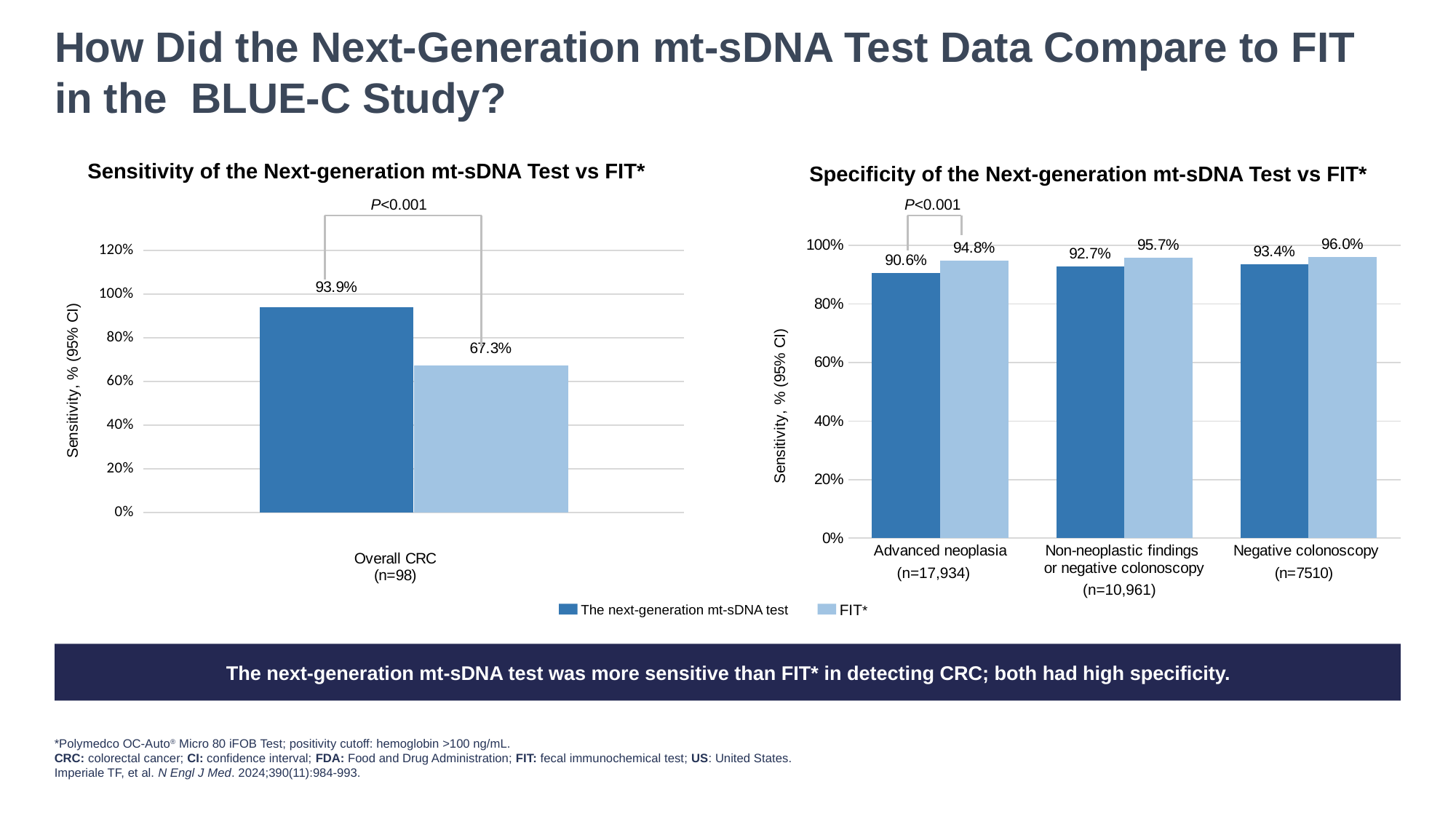
What kind of chart is the Sensitivity chart? Bar chart In the Specificity chart, what is the difference between FIT* and the next-generation mt-sDNA test for Advanced neoplasia? 4.2% In the Specificity chart, which category has the lowest value for the next-generation mt-sDNA test? Advanced neoplasia In the Sensitivity chart, what is the sensitivity of FIT* for Overall CRC? 67.3% In the Sensitivity chart, what is the sensitivity of the next-generation mt-sDNA test for Overall CRC? 93.9% In the Specificity chart, what is the value for the next-generation mt-sDNA test in the Non-neoplastic findings or negative colonoscopy category? 92.7% In the Sensitivity chart, which test has the higher value for Overall CRC? The next-generation mt-sDNA test In the Specificity chart, what is the value for FIT* in the Advanced neoplasia category? 94.8% In the Sensitivity chart, what is the difference between the next-generation mt-sDNA test and FIT* for Overall CRC? 26.6% How many series does the legend list? 2 In the Specificity chart, what is the value for the next-generation mt-sDNA test in the Negative colonoscopy category? 93.4% How many categories are shown on the x axis of the Specificity chart? 3